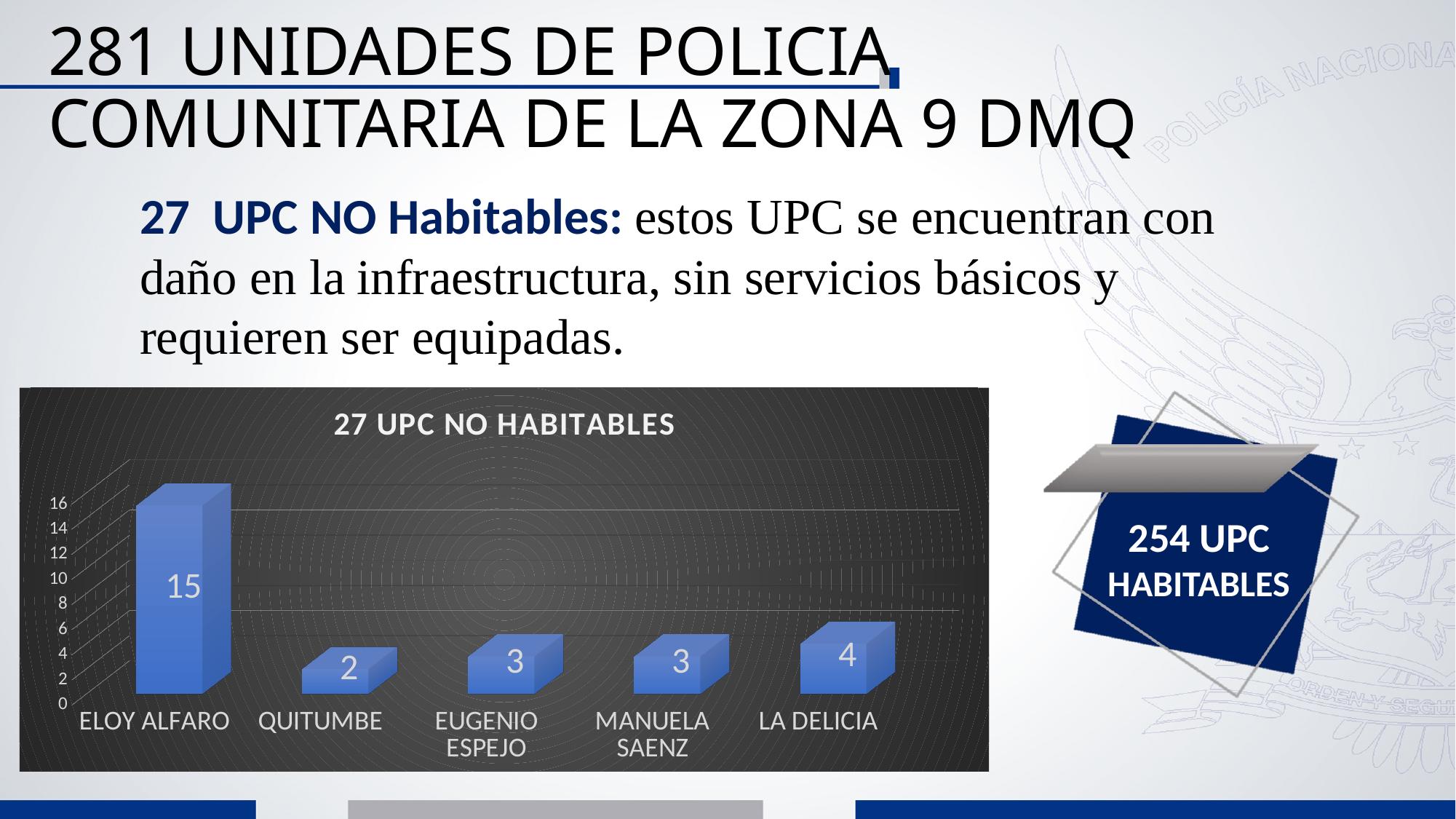
Is the value for ELOY ALFARO greater or less than 10? greater Which category has the highest value? ELOY ALFARO What is the value for MANUELA SAENZ? 3 What is the difference between the values for ELOY ALFARO and LA DELICIA? 11 Which is larger, the value for LA DELICIA or the value for QUITUMBE? LA DELICIA What is the value for ELOY ALFARO? 15 Which category has the lowest value? QUITUMBE How many categories are shown on the x axis? 5 What kind of chart is shown? bar chart What is the value for LA DELICIA? 4 What is the value for QUITUMBE? 2 What is the title of the chart? 27 UPC NO HABITABLES